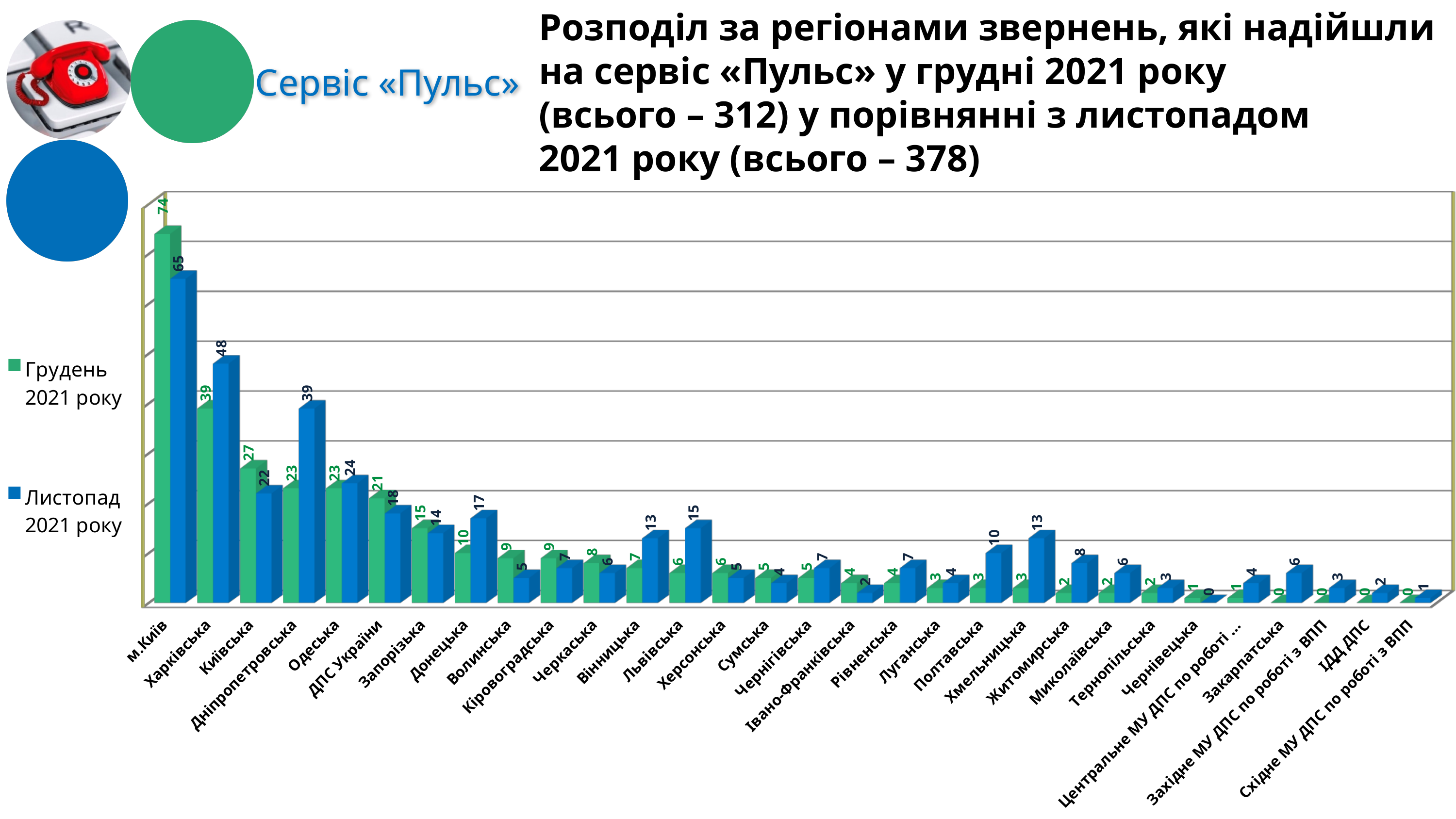
What is the difference between the Листопад 2021 року and Грудень 2021 року values for Харківська? 9 Which colour represents the Листопад 2021 року series in the legend? blue How many series does the legend list? 2 What is the value for Хмельницька in the Листопад 2021 року series? 13 For Львівська, which series has the larger value: Грудень 2021 року or Листопад 2021 року? Листопад 2021 року What kind of chart is shown on the slide? bar chart What is the value for Закарпатська in the Грудень 2021 року series? 0 Which region has the highest value in the Грудень 2021 року series? м.Київ For Київська, which series has the larger value: Грудень 2021 року or Листопад 2021 року? Грудень 2021 року What is the value for Дніпропетровська in the Листопад 2021 року series? 39 What is the value for м.Київ in the Грудень 2021 року series? 74 What is the difference between the Грудень 2021 року and Листопад 2021 року values for м.Київ? 9